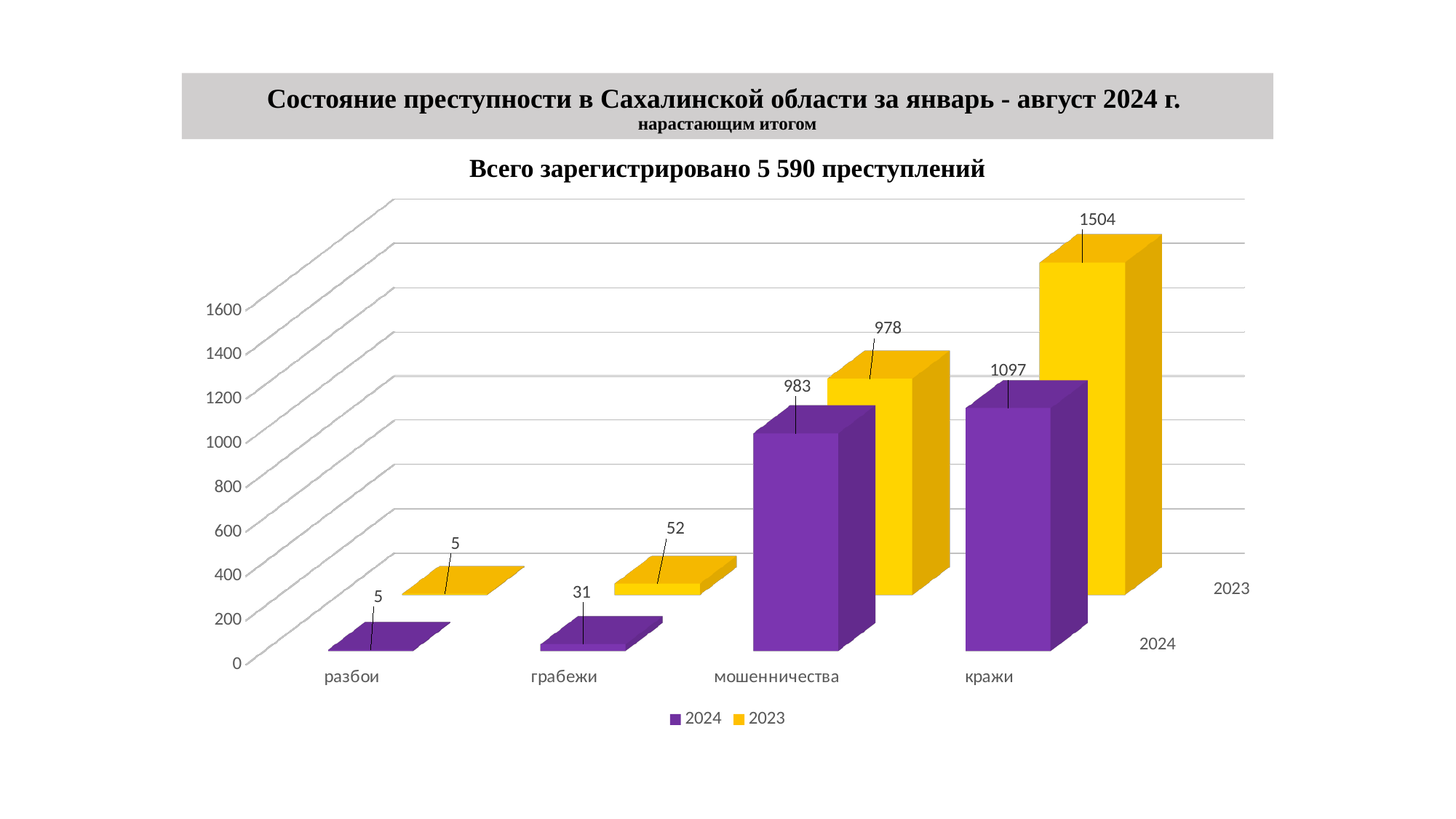
What is the value for кражи in the 2024 series? 1097 What kind of chart is shown on the slide? bar chart Which category has the lowest value in the 2024 series? разбои How many series does the legend list? 2 What is the value for разбои in the 2023 series? 5 How many categories are shown on the x axis? 4 What total number of registered crimes is stated in the chart title? 5 590 What is the difference between the 2023 and 2024 values for кражи? 407 What is the value for грабежи in the 2024 series? 31 What is the value for мошенничества in the 2023 series? 978 Which category has the highest value in the 2023 series? кражи Which is larger for грабежи: the 2024 value or the 2023 value? 2023